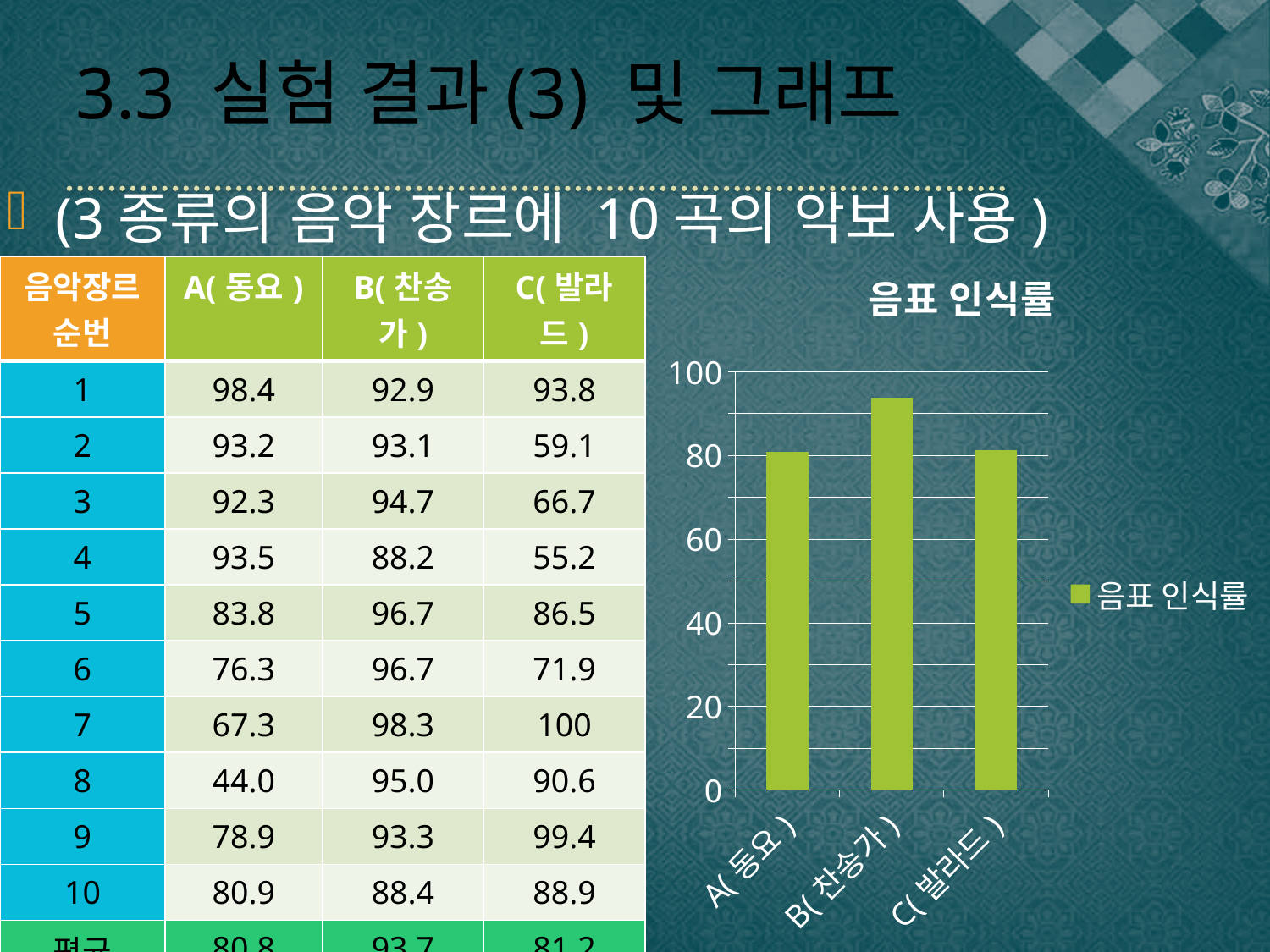
How many categories are plotted on the x axis of the chart? 3 Is the value for C( 발라드 ) greater or less than 100? less Is the value for A( 동요 ) greater or less than 60? greater Which is larger in the chart, the value for B( 찬송가 ) or the value for A( 동요 )? B( 찬송가 ) Is the value for A( 동요 ) greater or less than 90? less Which is larger in the chart, the value for C( 발라드 ) or the value for B( 찬송가 )? B( 찬송가 ) Which category has the highest bar in the chart? B( 찬송가 ) What kind of chart is shown on the slide? bar chart What is the title of the chart? 음표 인식률 How many series does the chart legend list? 1 What is the legend entry shown for the series in the chart? 음표 인식률